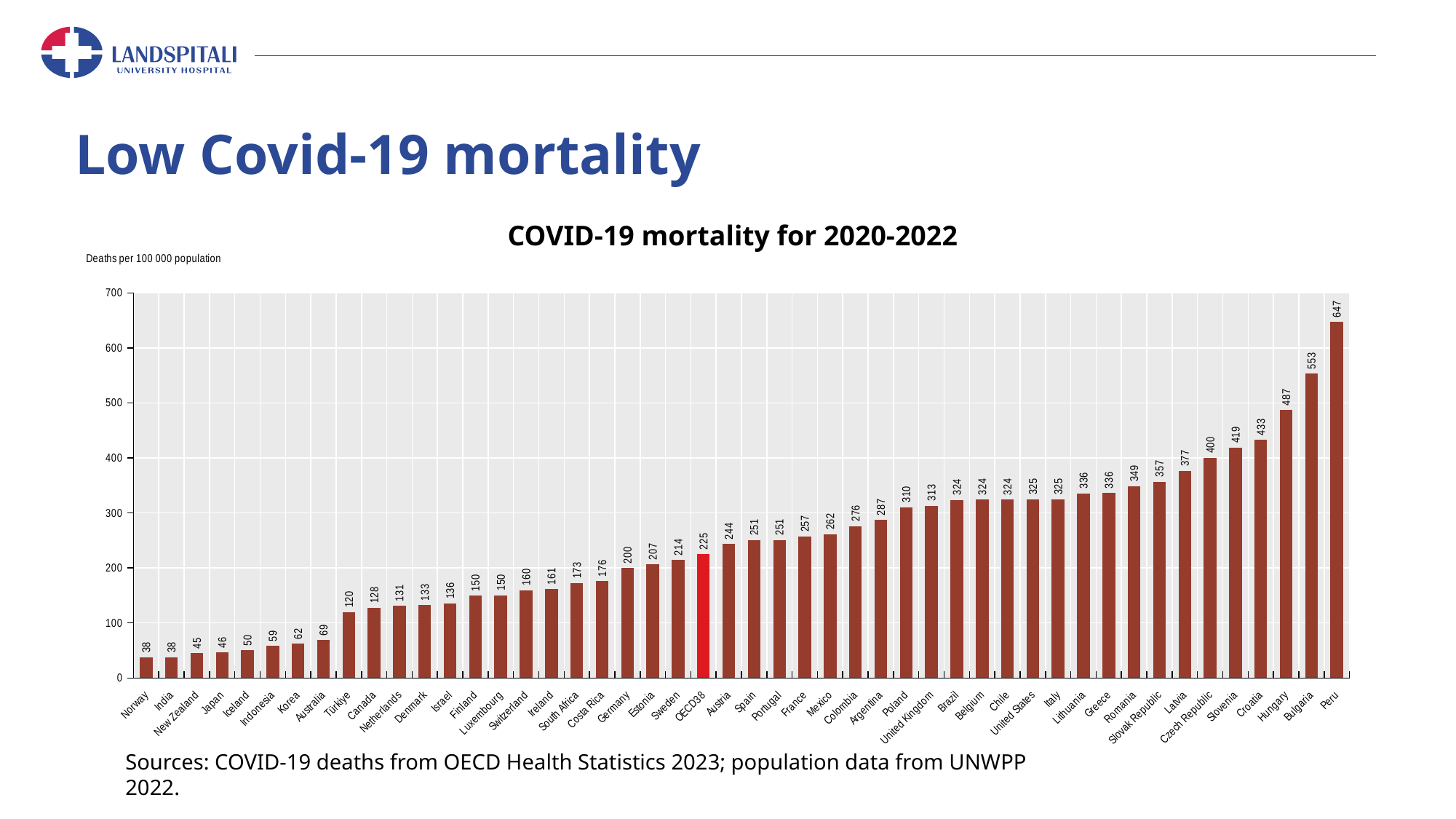
What is the difference between the values for Bulgaria and Hungary? 66 Do the values rise or fall from left to right along the x axis? Rise What is the value shown for the OECD38 bar? 225 What is the value shown for the United States? 325 Which country has the highest COVID-19 mortality in the chart? Peru What is the lowest value shown on the chart? 38 Is the value for Latvia greater or less than 400? less Which bar is highlighted in red? OECD38 What kind of chart is shown on the slide? Bar chart Which has a higher value, Germany or Sweden? Sweden What is the difference between the values for Peru and Iceland? 597 What is the COVID-19 mortality value shown for Iceland? 50